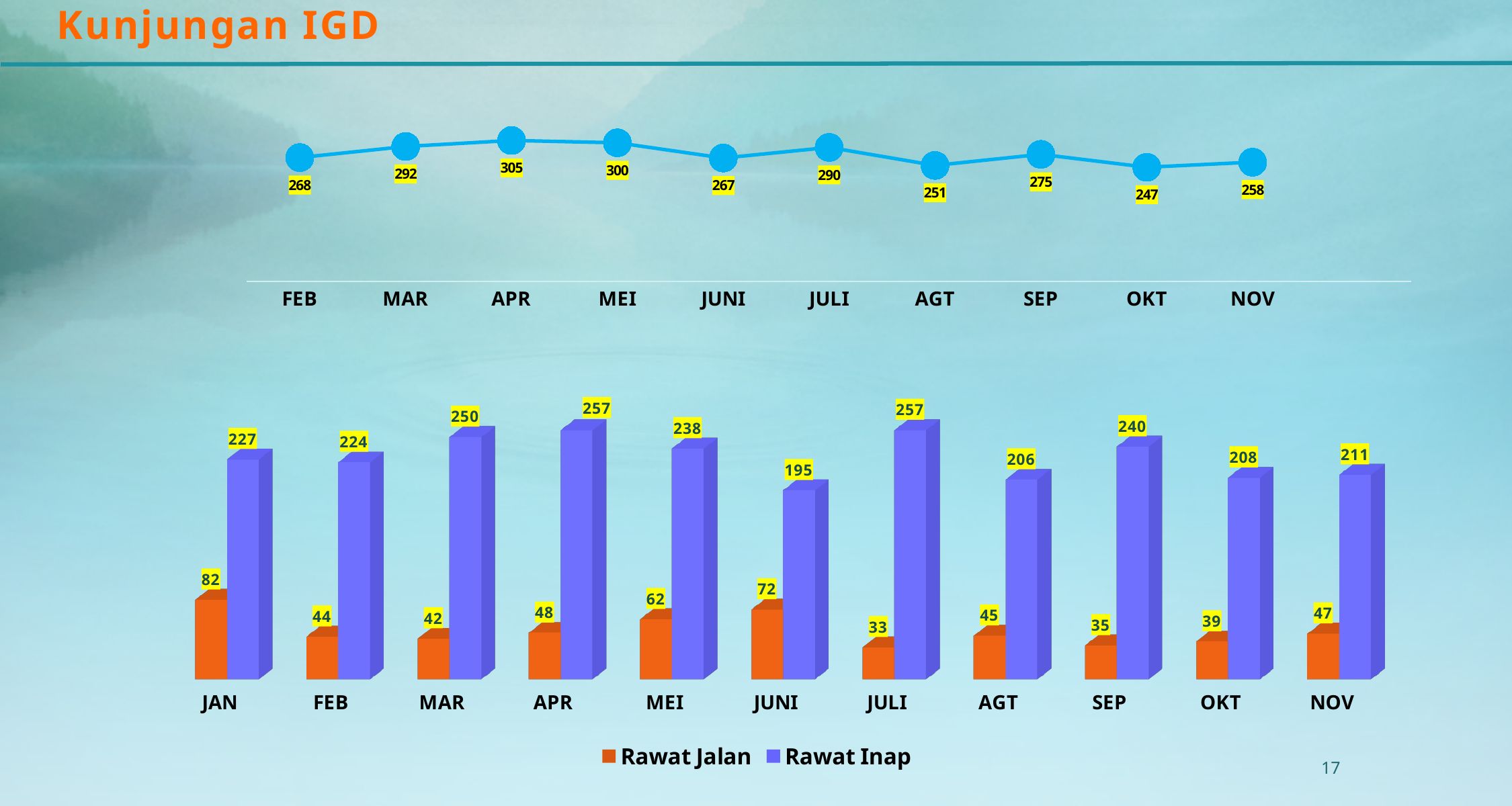
In the line chart at the top of the slide, which month has the lowest value? OKT In the line chart at the top of the slide, which month has the highest value? APR In the bar chart at the bottom of the slide, which month has the lowest Rawat Inap value? JUNI In the line chart at the top of the slide, what is the difference between the values for MAR and FEB? 24 In the bar chart at the bottom of the slide, which month has the highest Rawat Jalan value? JAN In the bar chart at the bottom of the slide, what is the Rawat Jalan value for JUNI? 72 What kind of chart is shown at the bottom of the slide? bar chart In the bar chart at the bottom of the slide, what is the Rawat Inap value for MEI? 238 In the line chart at the top of the slide, what is the value for APR? 305 In the bar chart at the bottom of the slide, is the Rawat Inap value for SEP larger or smaller than the Rawat Inap value for AGT? larger In the bar chart at the bottom of the slide, how many series does the legend list? 2 In the line chart at the top of the slide, how many data points are plotted? 10